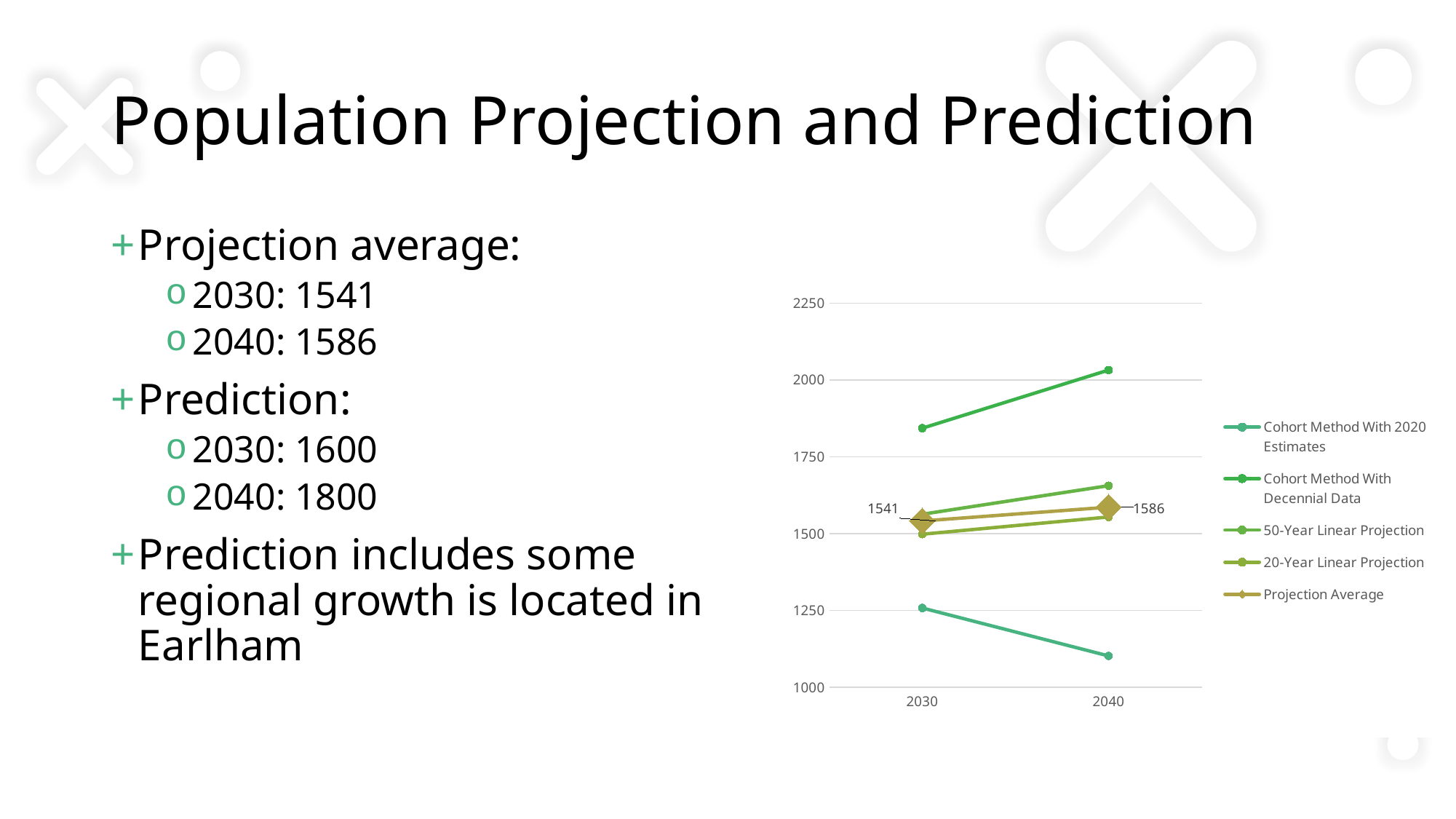
What kind of chart is shown on the slide? line chart How many series does the legend list? 5 Does the Cohort Method With Decennial Data series rise or fall from 2030 to 2040? rise Is the 2040 value for Cohort Method With Decennial Data greater or less than 2000? greater Is the 2030 value for Cohort Method With 2020 Estimates greater or less than 1500? less Does the Cohort Method With 2020 Estimates series rise or fall from 2030 to 2040? fall What is the value of the Projection Average series in 2030? 1541 Which series has the lowest value in 2030? Cohort Method With 2020 Estimates By how much does the Projection Average increase from 2030 to 2040? 45 How many years are shown on the x axis of the chart? 2 Which series has the highest value in 2040? Cohort Method With Decennial Data What is the value of the Projection Average series in 2040? 1586